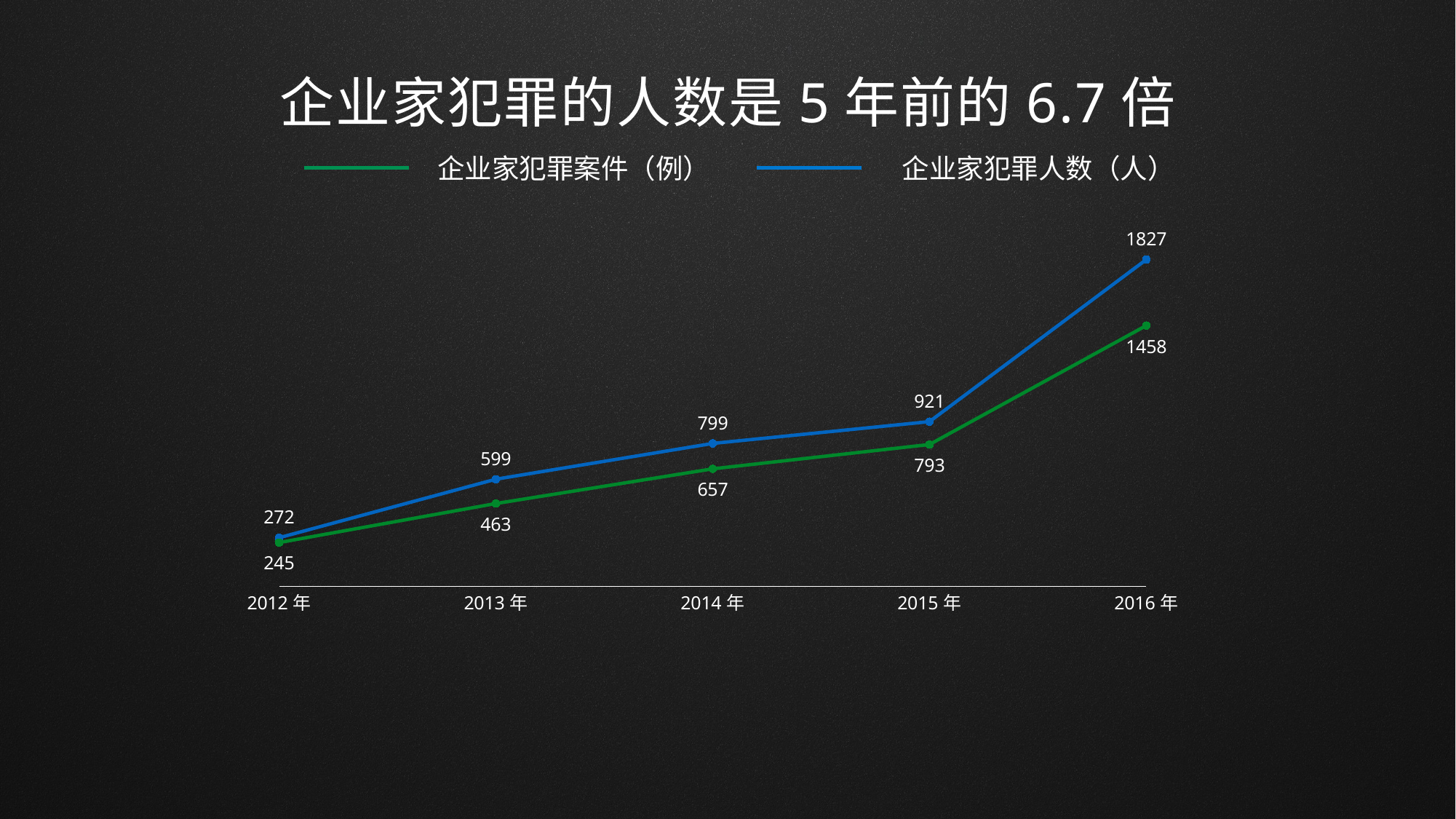
Which is larger in 2015 年: 企业家犯罪人数（人） or 企业家犯罪案件（例）? 企业家犯罪人数（人） In which year is 企业家犯罪案件（例） lowest? 2012 年 What kind of chart is shown on the slide? Line chart In which year is 企业家犯罪人数（人） highest? 2016 年 Does 企业家犯罪案件（例） rise or fall from 2012 年 to 2016 年? Rise How many years are shown on the x axis? 5 What is the difference between 企业家犯罪人数（人） and 企业家犯罪案件（例） in 2016 年? 369 What is the value of 企业家犯罪案件（例） in 2013 年? 463 What is the value of 企业家犯罪人数（人） in 2014 年? 799 What is the value of 企业家犯罪案件（例） in 2012 年? 245 How many series does the legend list? 2 What is the value of 企业家犯罪人数（人） in 2016 年? 1827